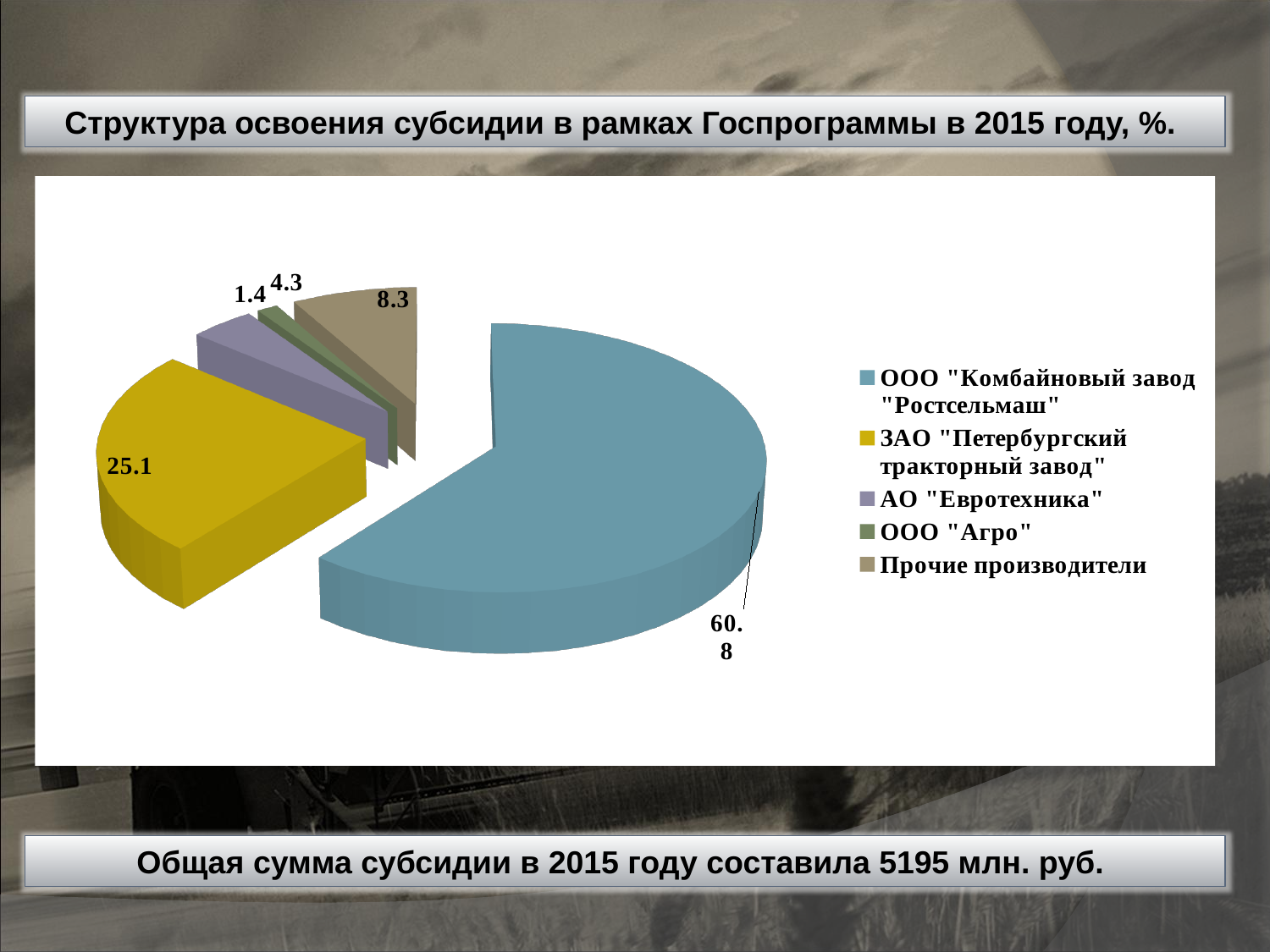
What kind of chart is shown on the slide? Pie chart Which category has the largest slice of the pie? ООО "Комбайновый завод "Ростсельмаш"" What is the smallest value labelled on the pie chart? 1.4 Which category has the smallest slice of the pie? ООО "Агро" What value is shown for Прочие производители? 8.3 Which is larger: the slice for Прочие производители or the slice for ЗАО "Петербургский тракторный завод"? ЗАО "Петербургский тракторный завод" How many entries does the legend list? 5 What is the difference between the values for ООО "Комбайновый завод "Ростсельмаш"" and ЗАО "Петербургский тракторный завод"? 35.7 What is the title of the chart on the slide? Структура освоения субсидии в рамках Госпрограммы в 2015 году, %. What value is shown for ЗАО "Петербургский тракторный завод"? 25.1 How many slices does the pie chart have? 5 What value is shown for ООО "Комбайновый завод "Ростсельмаш""? 60.8